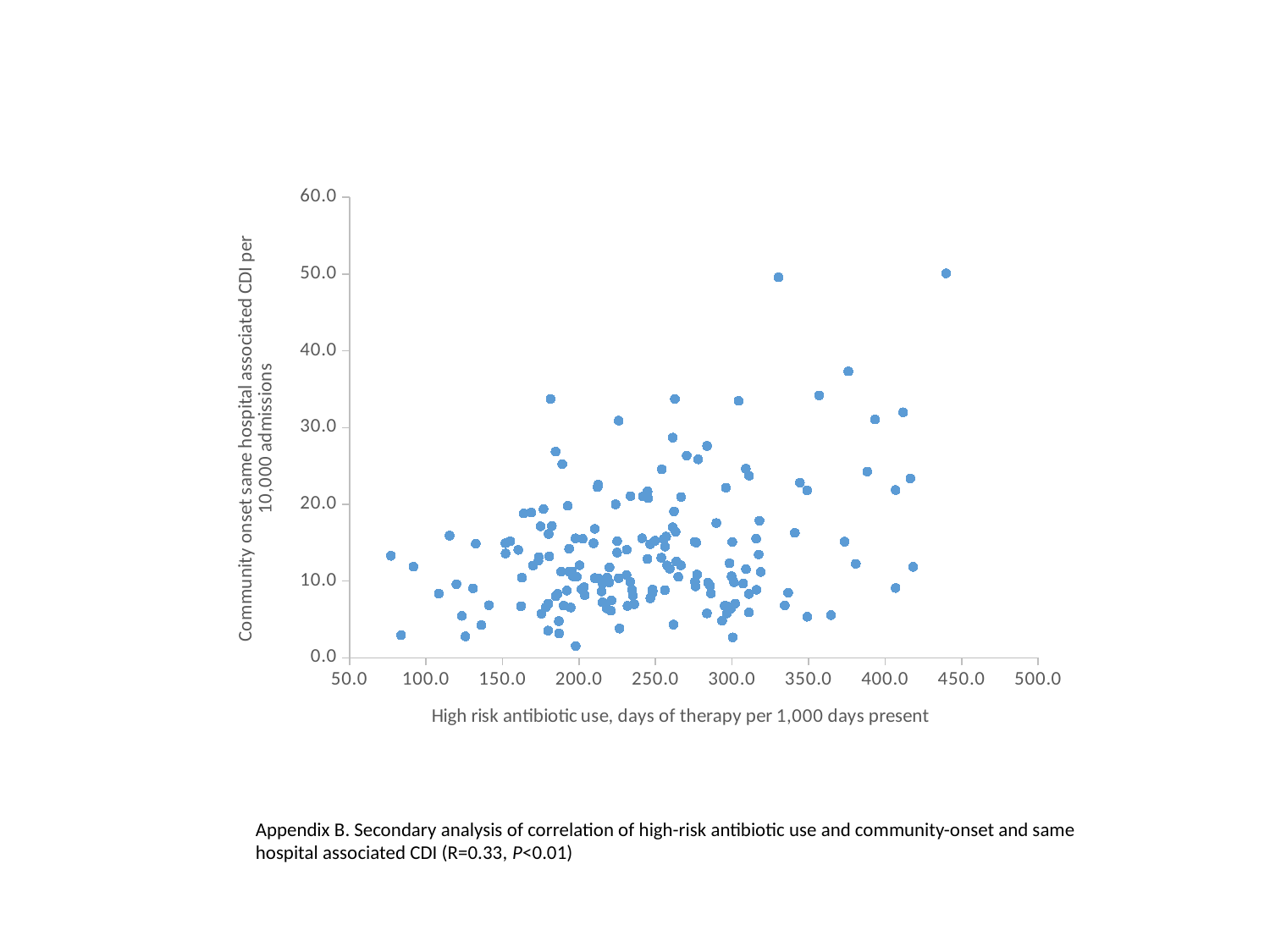
What kind of chart is shown on the slide? scatter plot What correlation coefficient R is reported for the relationship shown in the chart? 0.33 What is the label of the y axis of the chart? Community onset same hospital associated CDI per 10,000 admissions Is the highest plotted CDI value on the chart greater or less than 40.0? greater Are any points plotted with high risk antibiotic use less than 100.0? yes Are any points plotted with high risk antibiotic use greater than 450.0? no What is the label of the x axis of the chart? High risk antibiotic use, days of therapy per 1,000 days present What P value is reported for the correlation shown in the chart? P<0.01 As high risk antibiotic use increases along the x axis, do the CDI values tend to rise or fall? rise